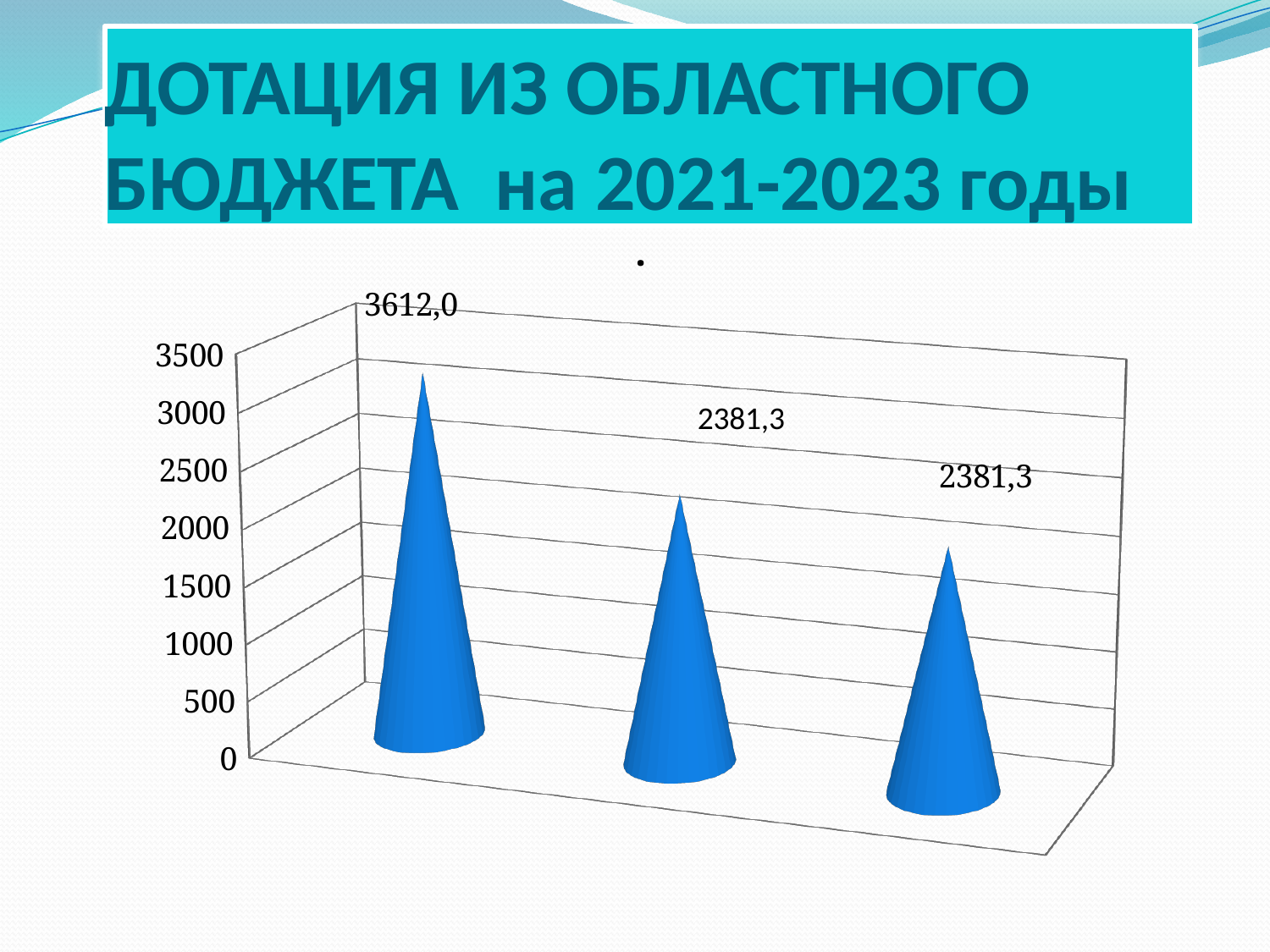
Is the value for the middle bar greater or less than 2500? less Which bar has the highest value? the leftmost bar What is the value shown for the rightmost bar? 2381,3 Which is larger, the value of the leftmost bar or the value of the rightmost bar? the leftmost bar What is the value shown for the middle bar? 2381,3 What is the difference between the leftmost bar's value and the middle bar's value? 1230,7 What is the value shown for the leftmost bar? 3612,0 How many bars are plotted on the chart? 3 What is the title of the slide? ДОТАЦИЯ ИЗ ОБЛАСТНОГО БЮДЖЕТА на 2021-2023 годы What kind of chart is shown on the slide? bar chart Is the value for the leftmost bar greater or less than 3000? greater